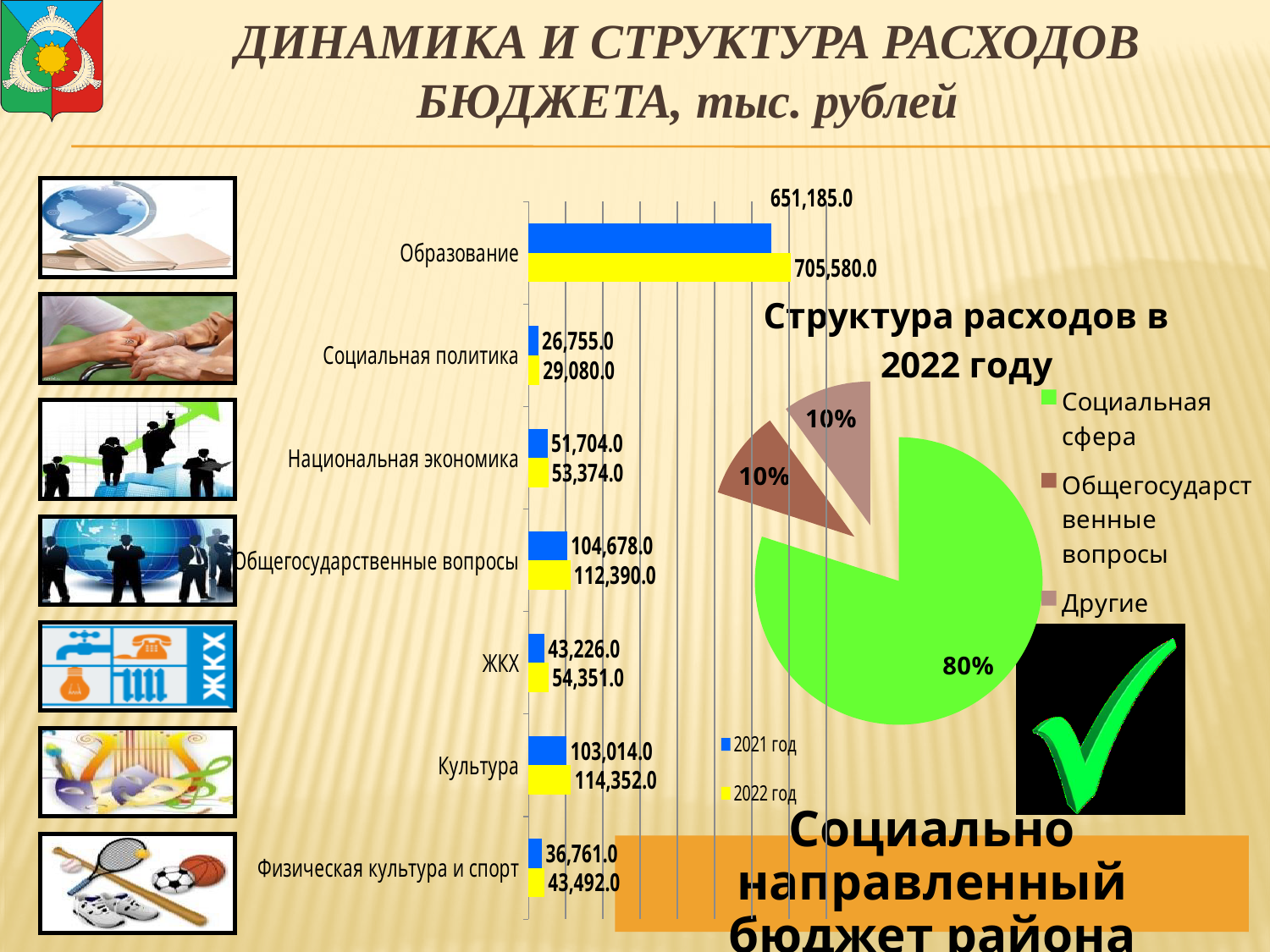
In the bar chart on the left, what is the value for Образование in 2022 год? 705,580.0 In the bar chart on the left, which is larger: the 2022 год value for Культура or the 2022 год value for Общегосударственные вопросы? Культура In the bar chart on the left, what is the value for ЖКХ in 2021 год? 43,226.0 What type of chart is 'Структура расходов в 2022 году'? pie chart In the bar chart on the left, what is the difference between the 2022 год and 2021 год values for Культура? 11,338.0 In the bar chart on the left, which category has the highest value in 2021 год? Образование In the bar chart on the left, what is the value for Физическая культура и спорт in 2022 год? 43,492.0 In the bar chart on the left, which category has the lowest value in 2022 год? Социальная политика How many series does the legend of the bar chart on the left list? 2 In the bar chart on the left, by how much did the value for Образование increase from 2021 год to 2022 год? 54,395.0 In the pie chart 'Структура расходов в 2022 году', what share does Социальная сфера have? 80% How many categories are shown in the bar chart on the left? 7